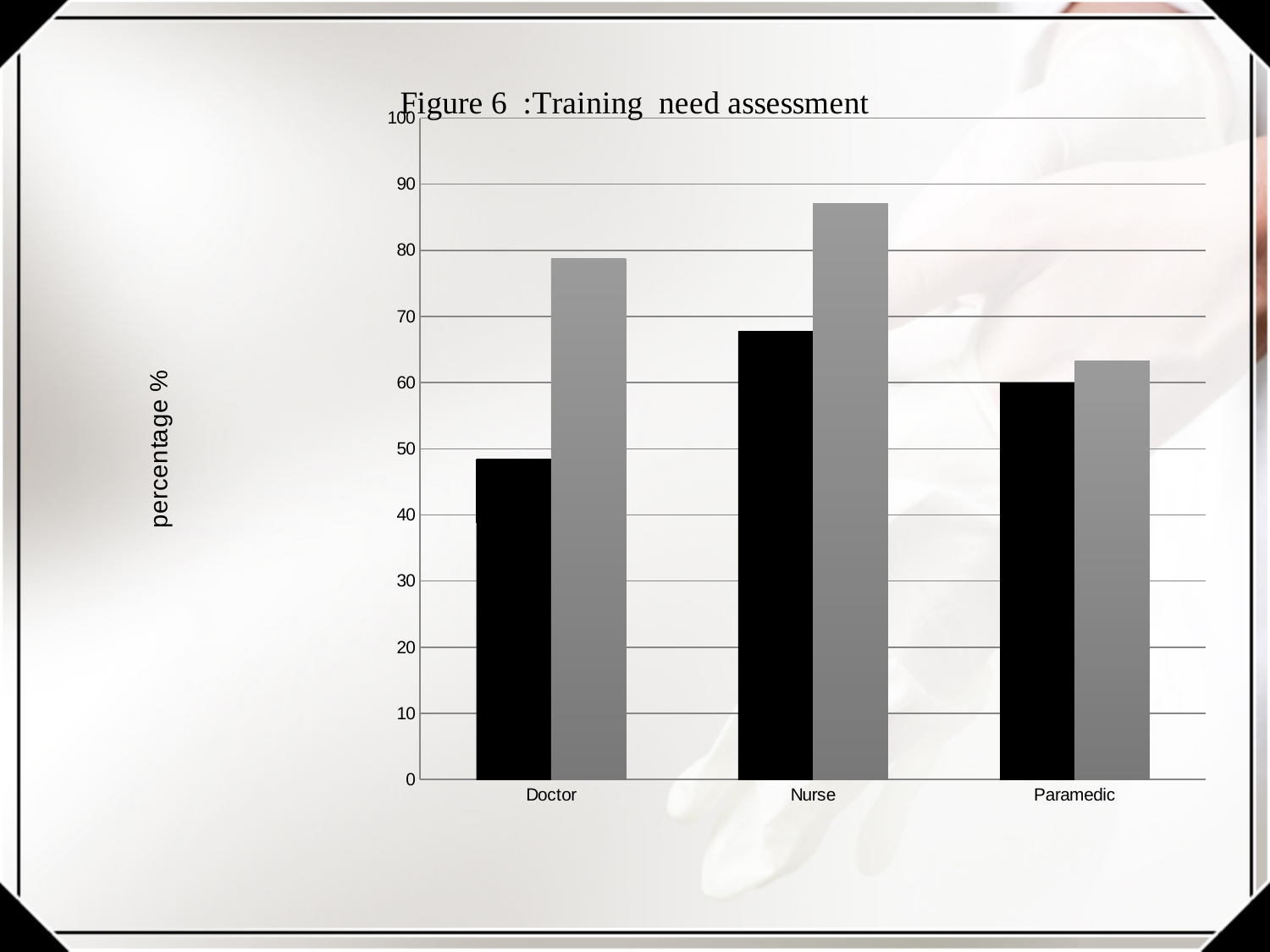
Is the value of the grey bar for Doctor greater or less than 70? greater Which category has the tallest black bar? Nurse What kind of chart is shown on the slide? bar chart How many categories are shown on the x axis of the chart? 3 What is the title of the chart? Figure 6 :Training need assessment What is the label on the vertical axis of the chart? percentage % Which category has the tallest grey bar? Nurse Is the value of the grey bar for Nurse greater or less than 80? greater For Doctor, which bar is larger, the black bar or the grey bar? the grey bar Is the value of the black bar for Doctor greater or less than 40? greater Which category has the shortest black bar? Doctor Which category has the shortest grey bar? Paramedic